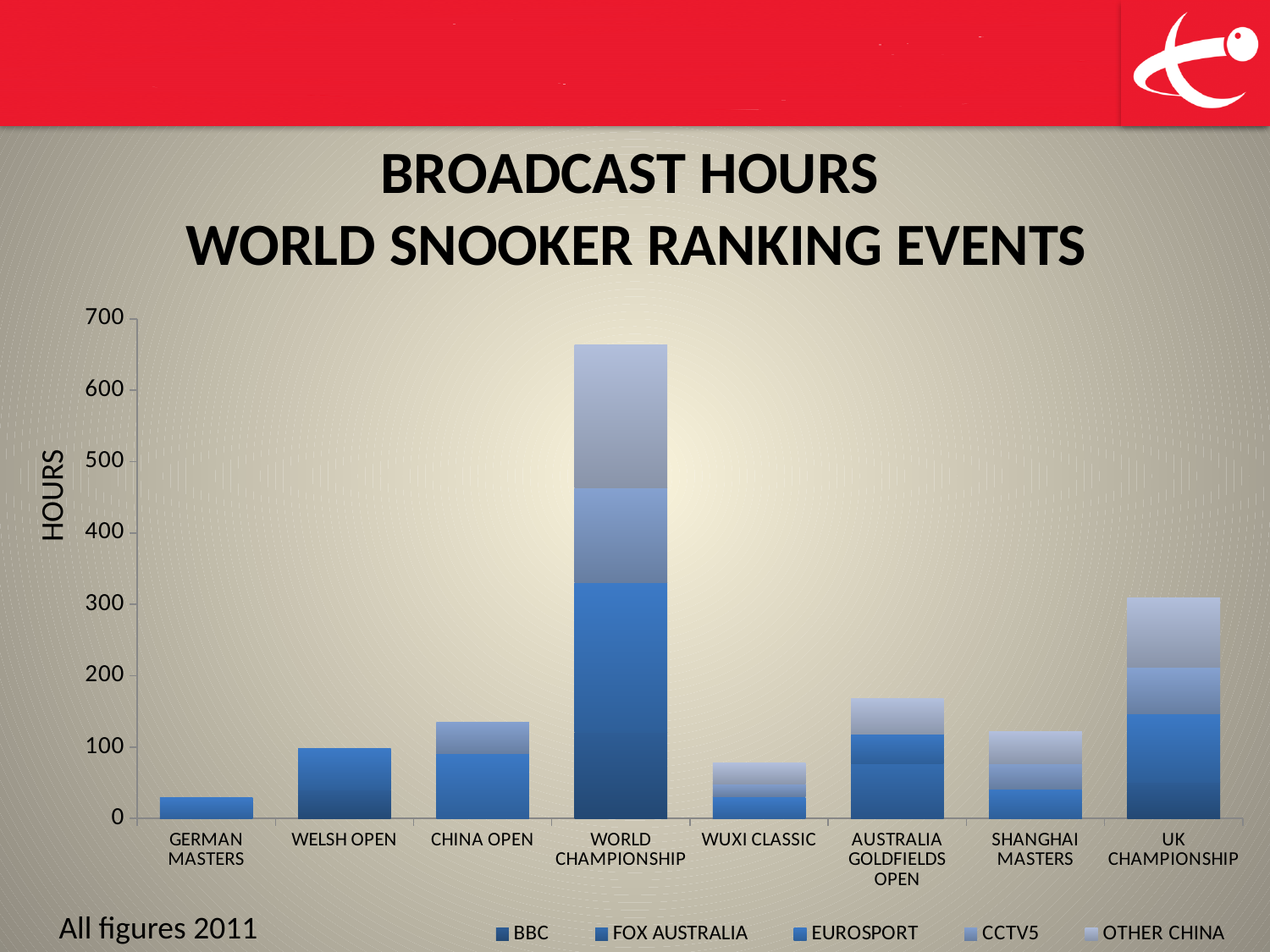
What is the label on the vertical axis of the chart? HOURS Is the total value for the Australia Goldfields Open greater or less than 200? less What kind of chart is shown on the slide? stacked bar chart Is the total value for the Wuxi Classic greater or less than 100? less How many events (categories) are shown on the x axis? 8 Is the total value for the World Championship greater or less than 600? greater How many series does the legend list? 5 Which has the larger total broadcast hours, the UK Championship or the China Open? UK Championship Which event has the lowest total broadcast hours? German Masters Which has the larger total broadcast hours, the Welsh Open or the Wuxi Classic? Welsh Open Which event has the highest total broadcast hours? World Championship